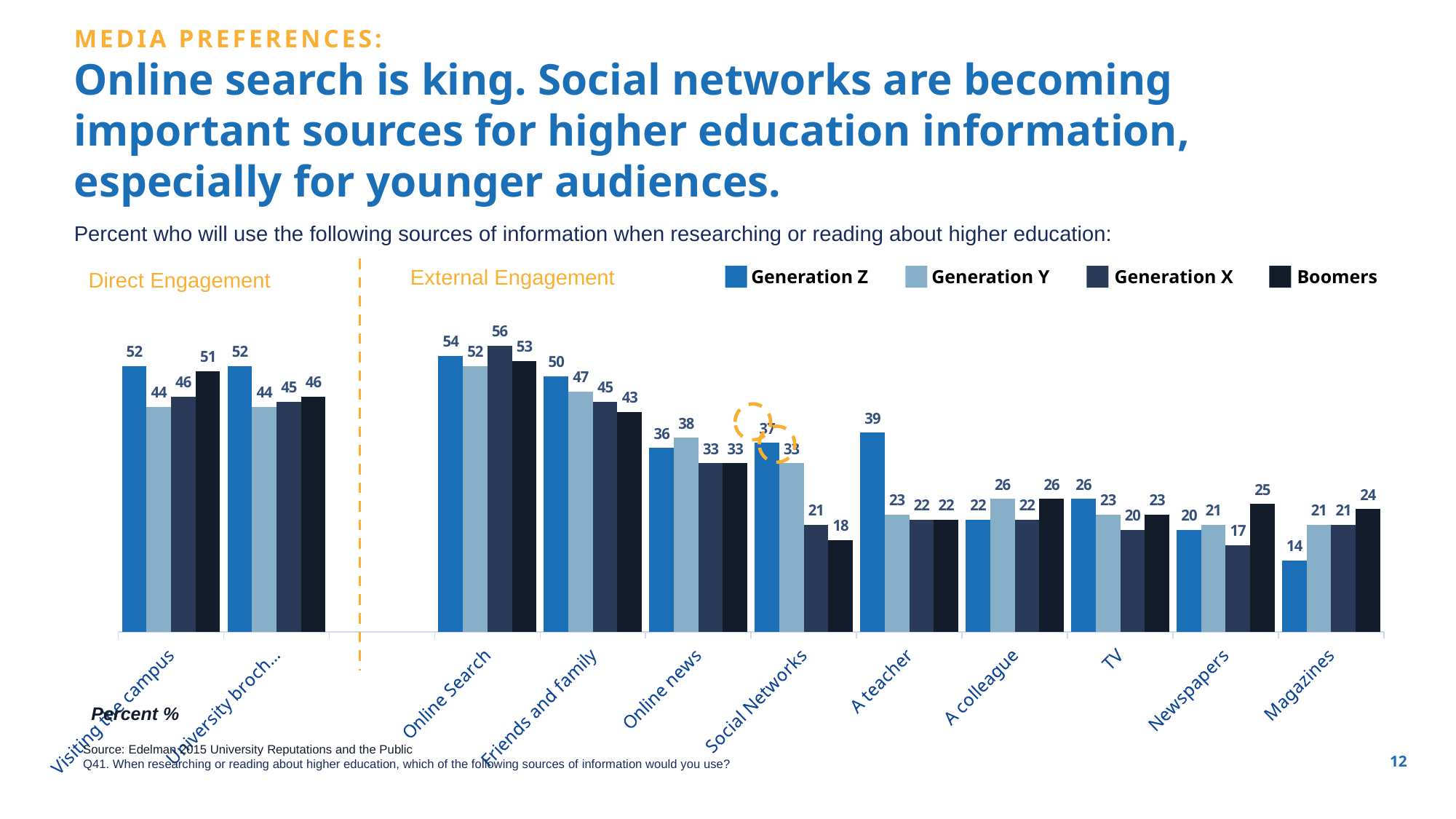
What is the value for Generation Y for Visiting the campus? 44 Which generation has the highest value for Online Search? Generation X How many series does the legend list? 4 What is the value for Generation X for Online Search? 56 How many categories are grouped under the Direct Engagement section? 2 What kind of chart is shown on the slide? Bar chart Which generation has the lowest value for Magazines? Generation Z What is the difference between the Generation Z and Boomers values for Friends and family? 7 What is the value for Generation Z for A teacher? 39 For Online news, which is larger: the Generation Y value or the Generation Z value? Generation Y What is the value for Boomers for Social Networks? 18 How many information sources (categories) are shown on the x axis? 11